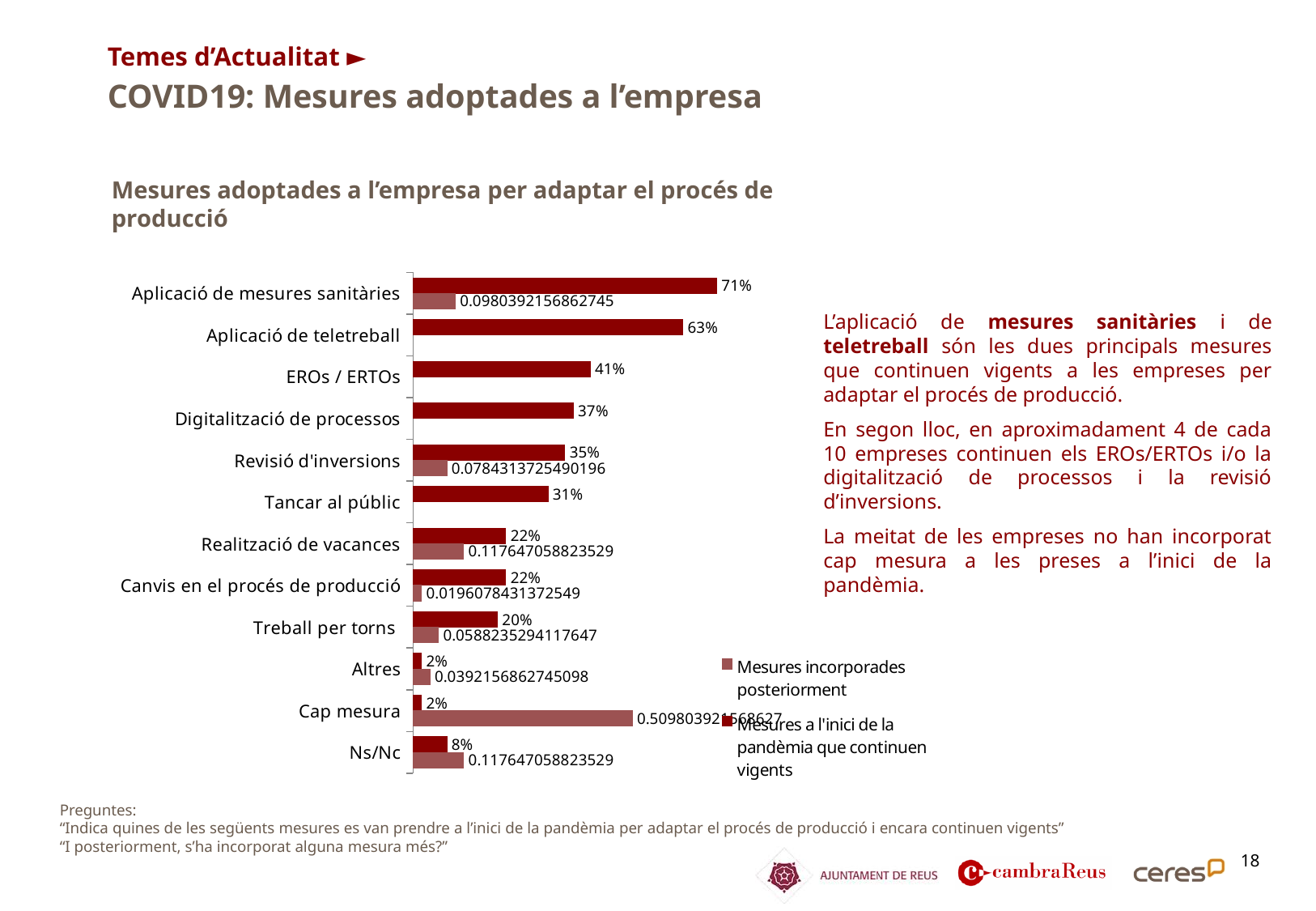
What is the difference between 'Aplicació de mesures sanitàries' and 'Aplicació de teletreball' in the series 'Mesures a l'inici de la pandèmia que continuen vigents'? 8% What is the value for 'Ns/Nc' in the series 'Mesures a l'inici de la pandèmia que continuen vigents'? 8% Which category has the highest value in the series 'Mesures a l'inici de la pandèmia que continuen vigents'? Aplicació de mesures sanitàries Which category has the longest bar in the series 'Mesures incorporades posteriorment'? Cap mesura What is the value for 'Aplicació de mesures sanitàries' in the series 'Mesures a l'inici de la pandèmia que continuen vigents'? 71% What type of chart is shown on the slide? bar chart What is the data label for 'Realització de vacances' in the series 'Mesures incorporades posteriorment'? 0.117647058823529 How many series does the legend list? 2 What is the value for 'EROs / ERTOs' in the series 'Mesures a l'inici de la pandèmia que continuen vigents'? 41% What is the data label for 'Treball per torns' in the series 'Mesures incorporades posteriorment'? 0.0588235294117647 Which is larger in the series 'Mesures a l'inici de la pandèmia que continuen vigents': 'Digitalització de processos' or 'Tancar al públic'? Digitalització de processos How many categories are shown on the chart? 12